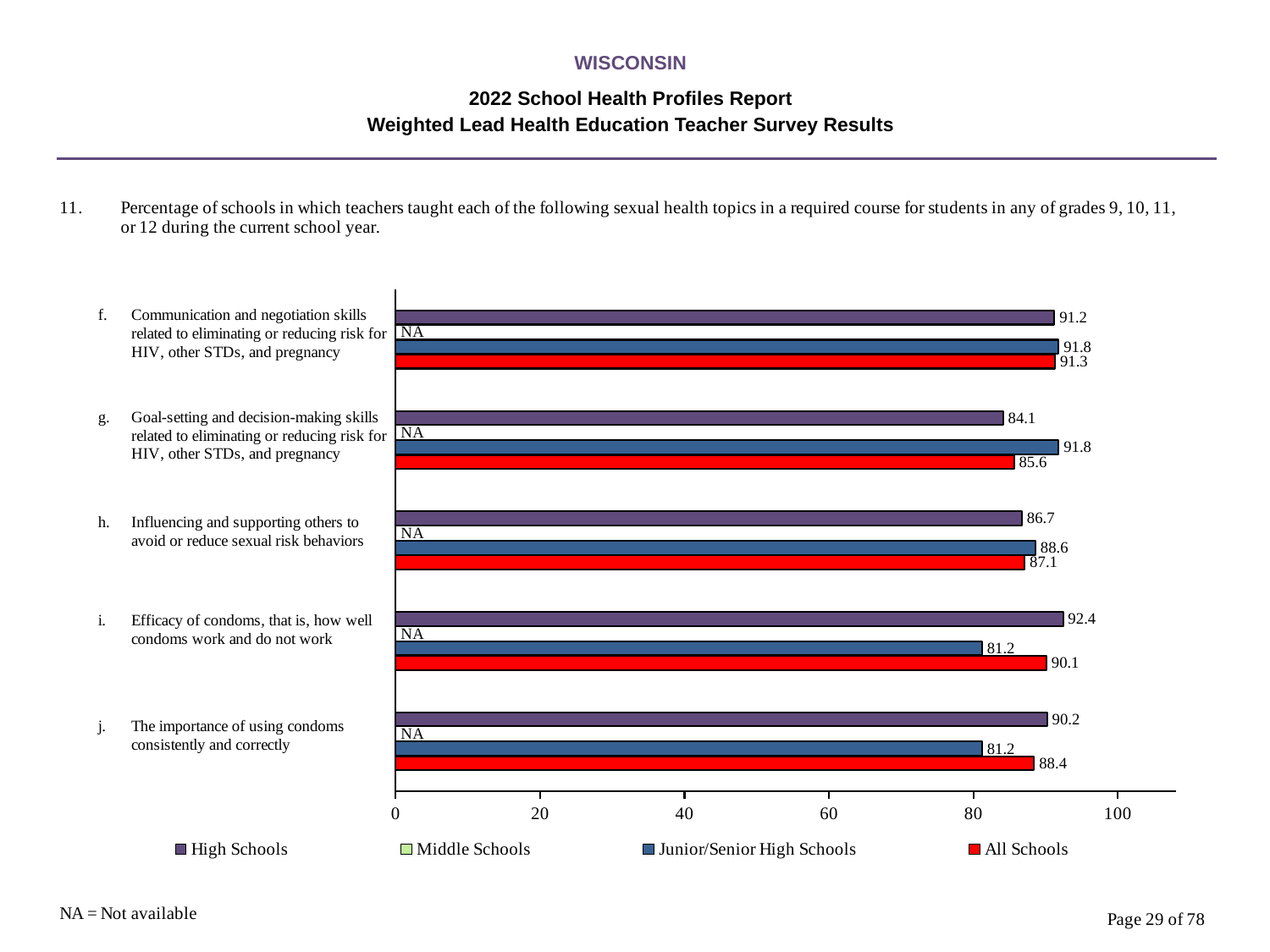
Which topic has the highest High Schools value? i. Efficacy of condoms, that is, how well condoms work and do not work How many series does the legend list? 4 What is the High Schools value for topic i, efficacy of condoms? 92.4 What value is shown for Middle Schools for topic j, the importance of using condoms consistently and correctly? NA What is the Junior/Senior High Schools value for topic h, influencing and supporting others to avoid or reduce sexual risk behaviors? 88.6 How many sexual health topics are listed on the chart? 5 Which topic has the lowest High Schools value? g. Goal-setting and decision-making skills related to eliminating or reducing risk for HIV, other STDs, and pregnancy What is the difference between the Junior/Senior High Schools value and the High Schools value for topic g? 7.7 For topic i, which is larger: the High Schools value or the Junior/Senior High Schools value? High Schools What kind of chart is shown on the slide? bar chart Is the All Schools value for topic j greater or less than 80? greater What is the All Schools value for topic g, goal-setting and decision-making skills? 85.6